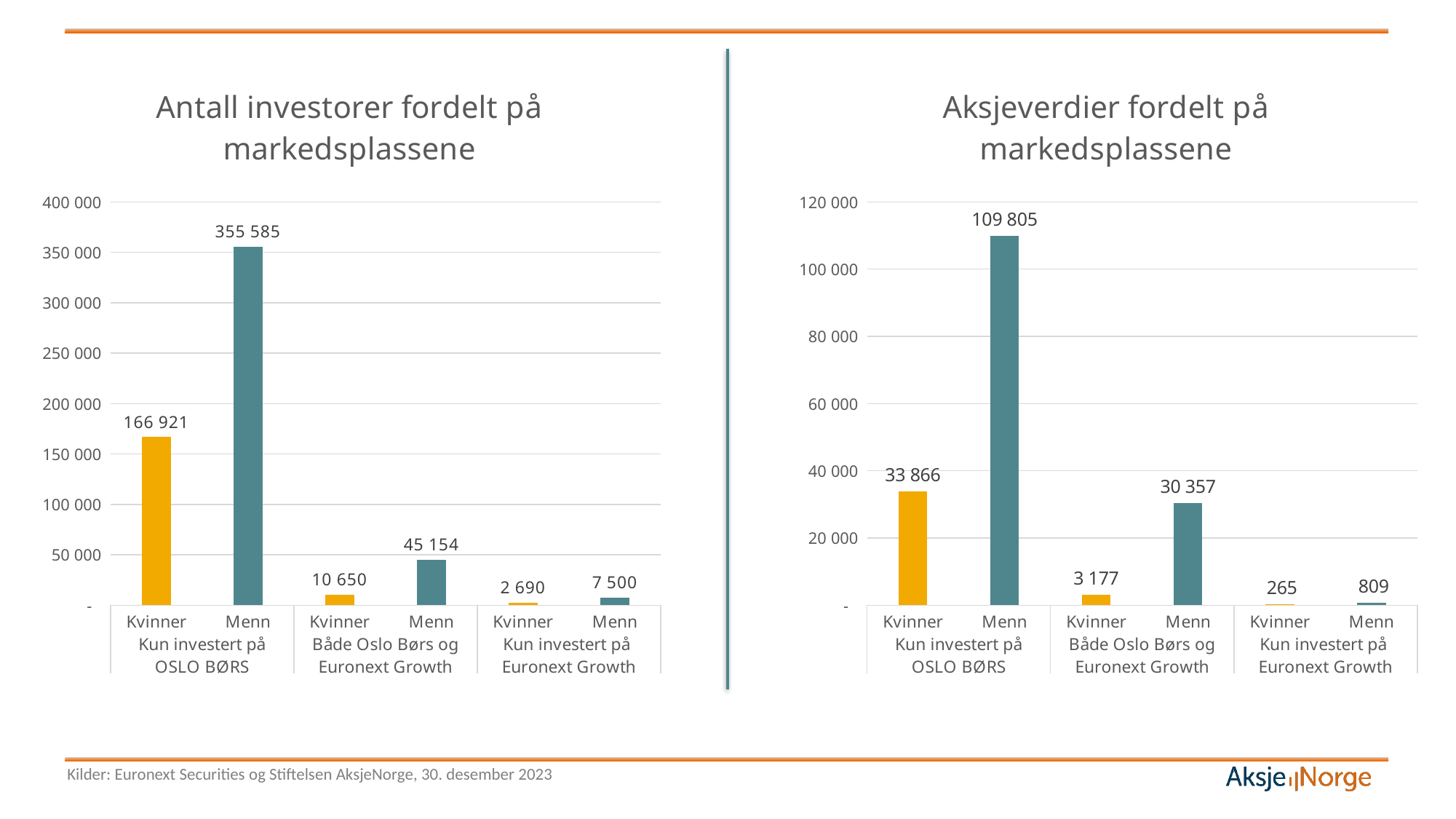
How many bars are plotted in the chart 'Antall investorer fordelt på markedsplassene'? 6 What kind of chart is 'Aksjeverdier fordelt på markedsplassene'? Bar chart In the chart 'Antall investorer fordelt på markedsplassene', what is the difference between Menn and Kvinner who are Kun investert på OSLO BØRS? 188 664 In the chart 'Antall investorer fordelt på markedsplassene', what is the value for Kvinner who are Både Oslo Børs og Euronext Growth? 10 650 In the chart 'Aksjeverdier fordelt på markedsplassene', what is the value for Kvinner who are Kun investert på Euronext Growth? 265 In the chart 'Aksjeverdier fordelt på markedsplassene', which bar has the lowest value? Kvinner, Kun investert på Euronext Growth In the chart 'Antall investorer fordelt på markedsplassene', what is the value for Menn who are Kun investert på OSLO BØRS? 355 585 In the chart 'Antall investorer fordelt på markedsplassene', which is larger: Menn Både Oslo Børs og Euronext Growth or Menn Kun investert på Euronext Growth? Menn Både Oslo Børs og Euronext Growth In the chart 'Aksjeverdier fordelt på markedsplassene', is the value for Menn Kun investert på OSLO BØRS greater or less than 100 000? greater In the chart 'Antall investorer fordelt på markedsplassene', which bar has the highest value? Menn, Kun investert på OSLO BØRS In the chart 'Aksjeverdier fordelt på markedsplassene', what is the difference between Menn and Kvinner who are Både Oslo Børs og Euronext Growth? 27 180 In the chart 'Aksjeverdier fordelt på markedsplassene', what is the value for Menn who are Både Oslo Børs og Euronext Growth? 30 357